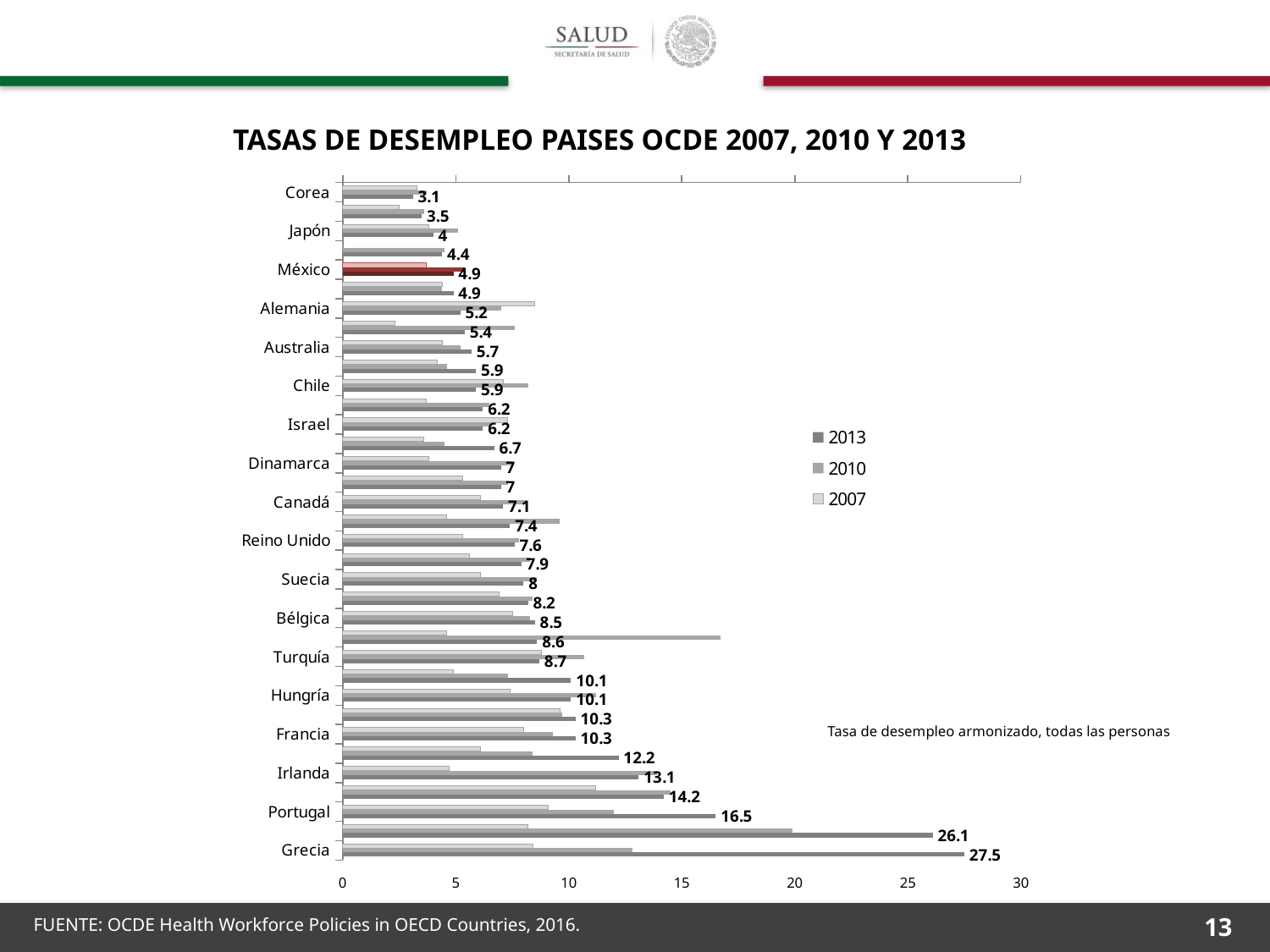
What is the 2013 unemployment rate for Grecia? 27.5 Which country has the lowest 2013 unemployment rate? Corea How many series does the legend list? 3 Which country has the highest 2013 unemployment rate? Grecia What kind of chart is shown on the slide? bar chart What is the 2013 unemployment rate for Portugal? 16.5 Which has the larger 2013 unemployment rate, Irlanda or Francia? Irlanda What is the difference between the 2013 unemployment rates of Grecia and Portugal? 11 Is the 2010 value for Grecia greater or less than 10? greater What is the 2013 unemployment rate for México? 4.9 Do the 2013 values increase or decrease going from the top of the chart (Corea) to the bottom (Grecia)? increase Which country's bar is highlighted in red on the chart? México